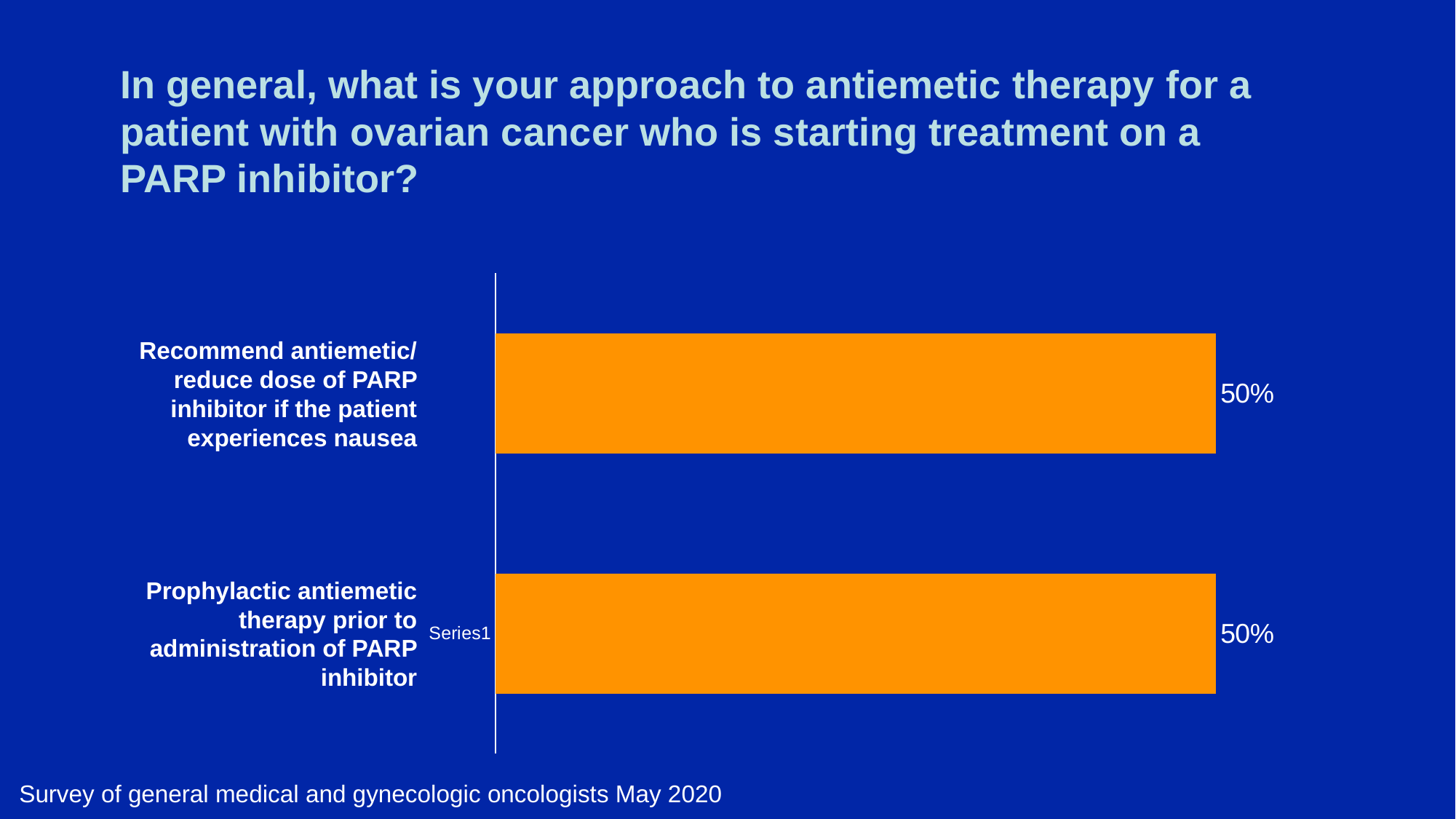
How many response categories are shown in the chart? 2 What is the total of the two values shown in the chart? 100% What kind of chart is shown on the slide? Bar chart Is the value for 'Prophylactic antiemetic therapy prior to administration of PARP inhibitor' equal to the value for 'Recommend antiemetic/reduce dose of PARP inhibitor if the patient experiences nausea'? Yes What percentage of respondents chose 'Recommend antiemetic/reduce dose of PARP inhibitor if the patient experiences nausea'? 50% Are the bars in the chart oriented horizontally or vertically? Horizontally What colour are the bars in the chart? Orange What is the difference between the value for 'Prophylactic antiemetic therapy prior to administration of PARP inhibitor' and the value for 'Recommend antiemetic/reduce dose of PARP inhibitor if the patient experiences nausea'? 0% What percentage of respondents chose 'Prophylactic antiemetic therapy prior to administration of PARP inhibitor'? 50%